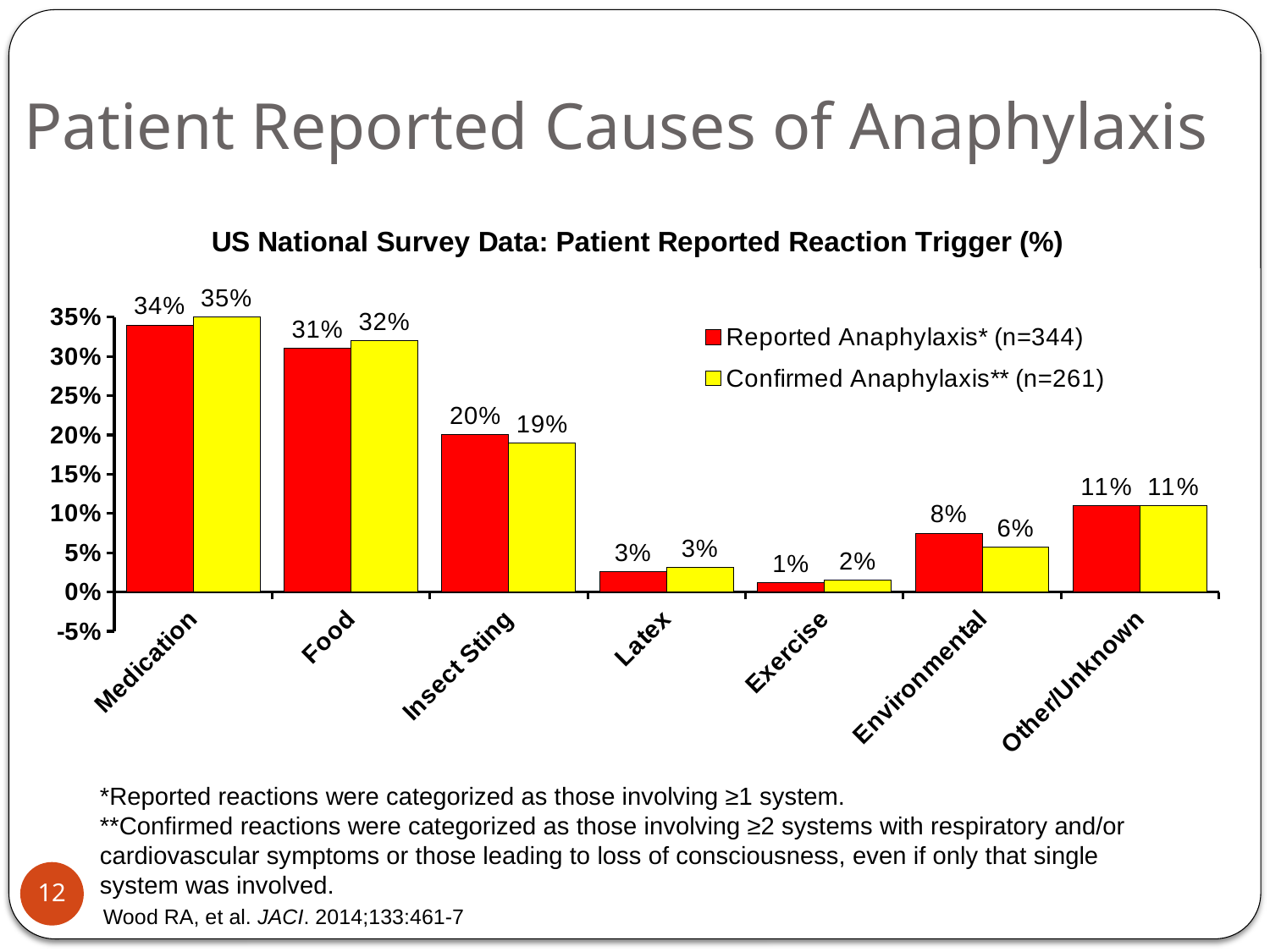
Which category has the highest Reported Anaphylaxis value? Medication What is the Confirmed Anaphylaxis value for Food? 32% What colour are the bars for Confirmed Anaphylaxis? Yellow What is the difference between the Reported and Confirmed Anaphylaxis values for Insect Sting? 1% What is the Reported Anaphylaxis value for Medication? 34% What is the Confirmed Anaphylaxis value for Environmental? 6% How many series does the legend list? 2 What kind of chart is shown on the slide? Bar chart How many categories are shown on the x axis? 7 Which category has the lowest Confirmed Anaphylaxis value? Exercise Which is larger for Environmental: the Reported Anaphylaxis value or the Confirmed Anaphylaxis value? Reported Anaphylaxis What is the title of the chart? US National Survey Data: Patient Reported Reaction Trigger (%)